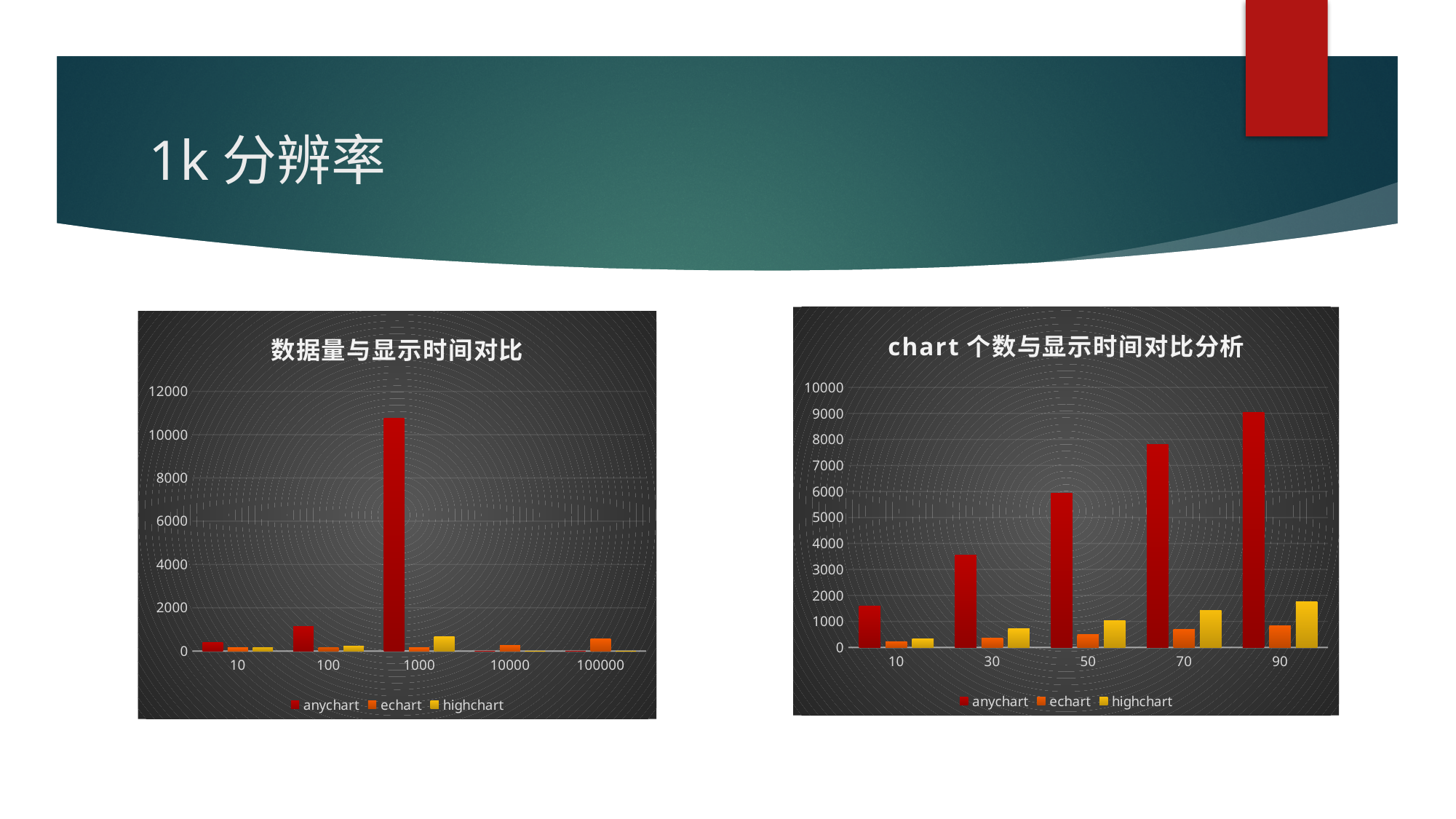
In the left chart (数据量与显示时间对比), which series is shown in yellow? highchart What is the title of the right chart? chart 个数与显示时间对比分析 In the left chart (数据量与显示时间对比), at which category is the anychart bar highest? 1000 In the left chart (数据量与显示时间对比), is the anychart value at 1000 greater or less than 10000? greater In the right chart (chart 个数与显示时间对比分析), is the anychart value at 10 greater or less than 2000? less In the right chart (chart 个数与显示时间对比分析), at which category is the anychart bar highest? 90 In the right chart (chart 个数与显示时间对比分析), how many series does the legend list? 3 In the right chart (chart 个数与显示时间对比分析), do the anychart values rise or fall as the x axis goes from 10 to 90? rise In the right chart (chart 个数与显示时间对比分析), is the anychart value at 90 greater or less than 8000? greater What kind of chart is the left chart titled 数据量与显示时间对比? bar chart In the right chart (chart 个数与显示时间对比分析), which is larger at category 90: anychart or highchart? anychart In the left chart (数据量与显示时间对比), how many categories are shown on the x axis? 5